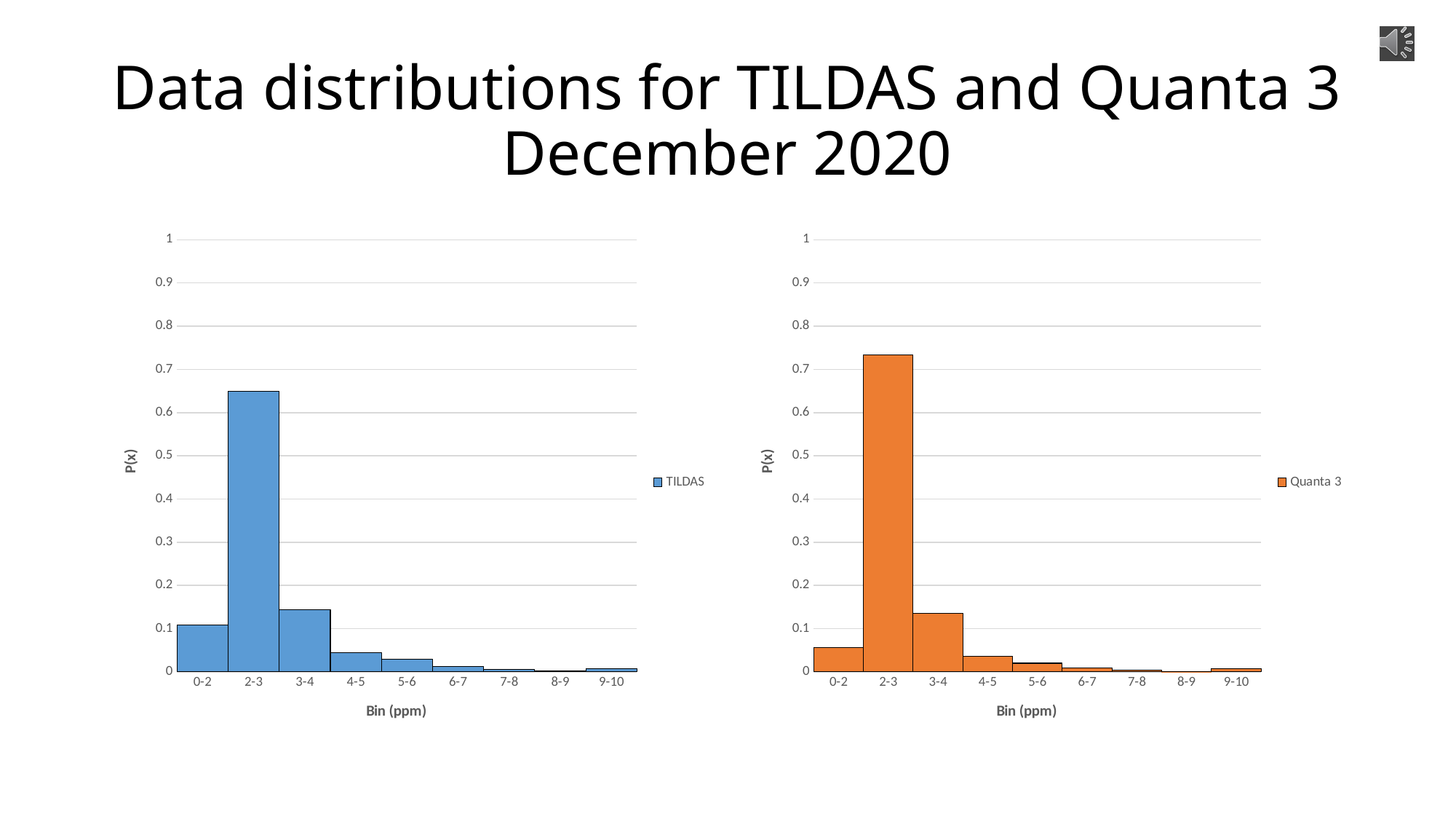
In the left chart (TILDAS), is the value for the 2-3 bin greater or less than 0.6? greater In the right chart (Quanta 3), which bin has the highest P(x)? 2-3 How many series does the legend of the left chart (TILDAS) list? 1 In the right chart (Quanta 3), is the value for the 0-2 bin greater or less than 0.1? less In the right chart (Quanta 3), which bin has the larger P(x): 0-2 or 3-4? 3-4 How many bins are shown on the x axis of the right chart (Quanta 3)? 9 In the right chart (Quanta 3), is the value for the 2-3 bin greater or less than 0.7? greater What is the x-axis title of the right chart (Quanta 3)? Bin (ppm) In the left chart (TILDAS), which bin has the highest P(x)? 2-3 In the left chart (TILDAS), which bin has the larger P(x): 2-3 or 3-4? 2-3 What kind of chart is the left chart (TILDAS)? bar chart